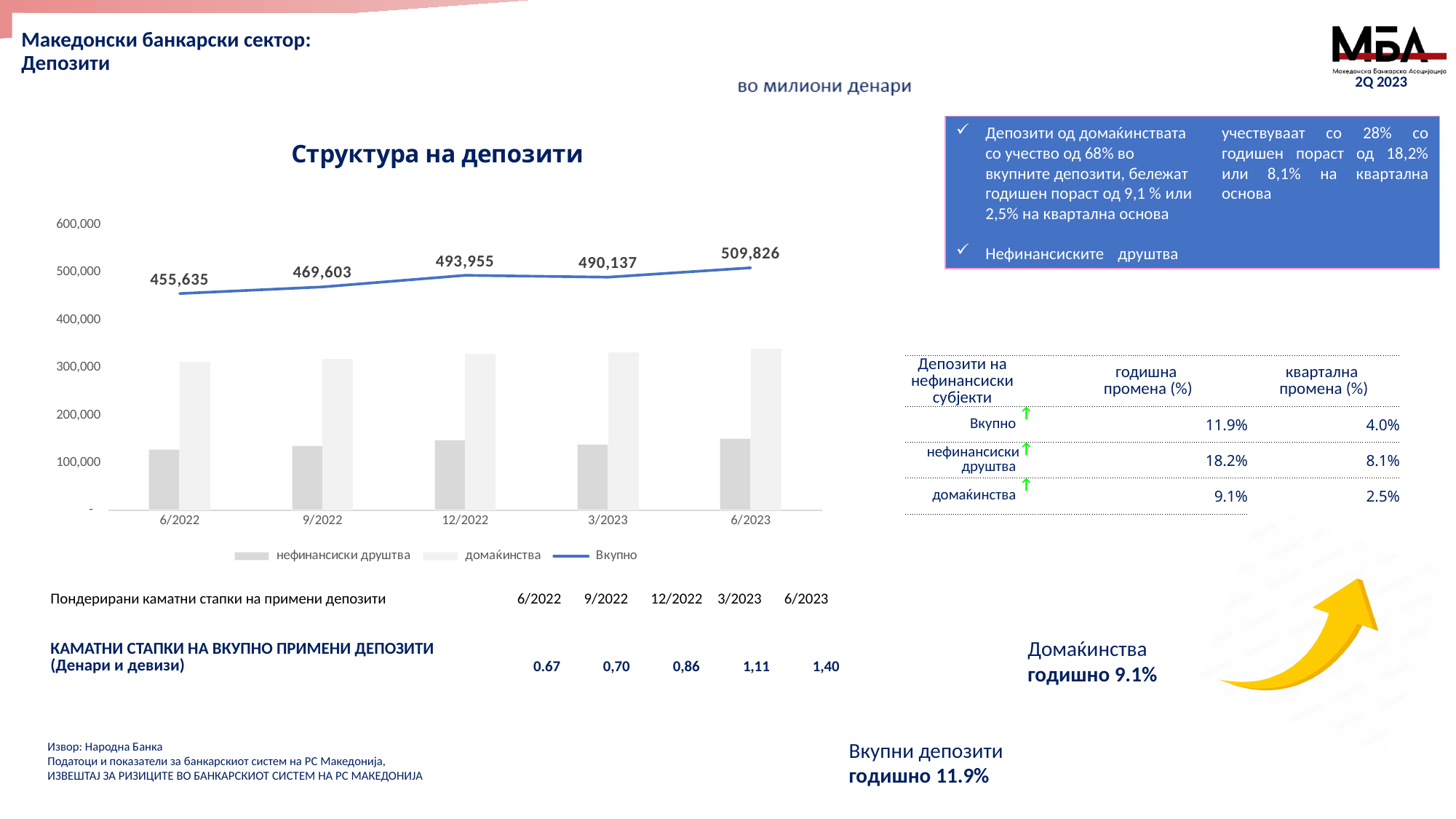
How many periods are shown on the x axis of the Структура на депозити chart? 5 In which period is the Вкупно line lowest in the Структура на депозити chart? 6/2022 How many series does the legend of the Структура на депозити chart list? 3 In the Структура на депозити chart, is the нефинансиски друштва bar for 6/2022 greater or less than 200,000? less In the Структура на депозити chart, is the домаќинства bar for 6/2023 greater or less than 300,000? greater In which period is the Вкупно line highest in the Структура на депозити chart? 6/2023 What is the value of Вкупно for 6/2022 in the Структура на депозити chart? 455,635 What kind of chart is Структура на депозити? Combined bar and line chart Does the Вкупно line in the Структура на депозити chart rise or fall from 6/2022 to 6/2023 overall? rise What is the value of Вкупно for 6/2023 in the Структура на депозити chart? 509,826 What is the difference between the Вкупно values for 6/2023 and 6/2022 in the Структура на депозити chart? 54,191 Which period has the larger Вкупно value in the Структура на депозити chart, 12/2022 or 3/2023? 12/2022